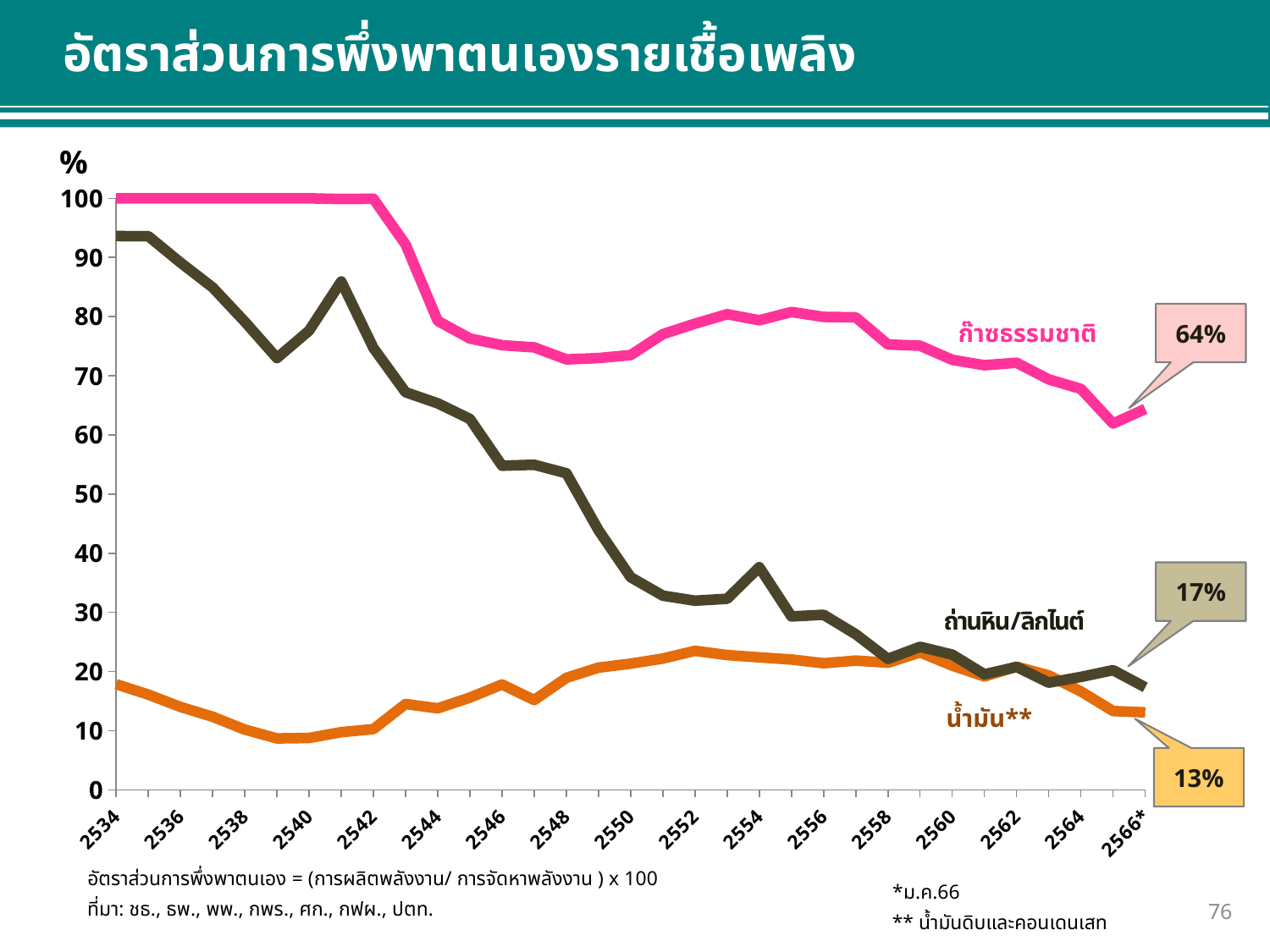
At 2566*, which is larger: ถ่านหิน/ลิกไนต์ or น้ำมัน**? ถ่านหิน/ลิกไนต์ Is the value for น้ำมัน** at 2540 greater or less than 10? less Does the ถ่านหิน/ลิกไนต์ line generally rise or fall from 2534 to 2566*? fall What is the value for น้ำมัน** (oil) at 2566*? 13% What kind of chart is shown on the slide? line chart Which fuel has the highest self-reliance ratio at 2566*? ก๊าซธรรมชาติ Is the value for ก๊าซธรรมชาติ at 2534 greater or less than 90? greater Which fuel has the lowest self-reliance ratio at 2566*? น้ำมัน** What is the value for ก๊าซธรรมชาติ (natural gas) at 2566*? 64% What is the difference between the ก๊าซธรรมชาติ value and the ถ่านหิน/ลิกไนต์ value at 2566*? 47% What is the value for ถ่านหิน/ลิกไนต์ (coal/lignite) at 2566*? 17% How many fuel series are plotted on the chart? 3